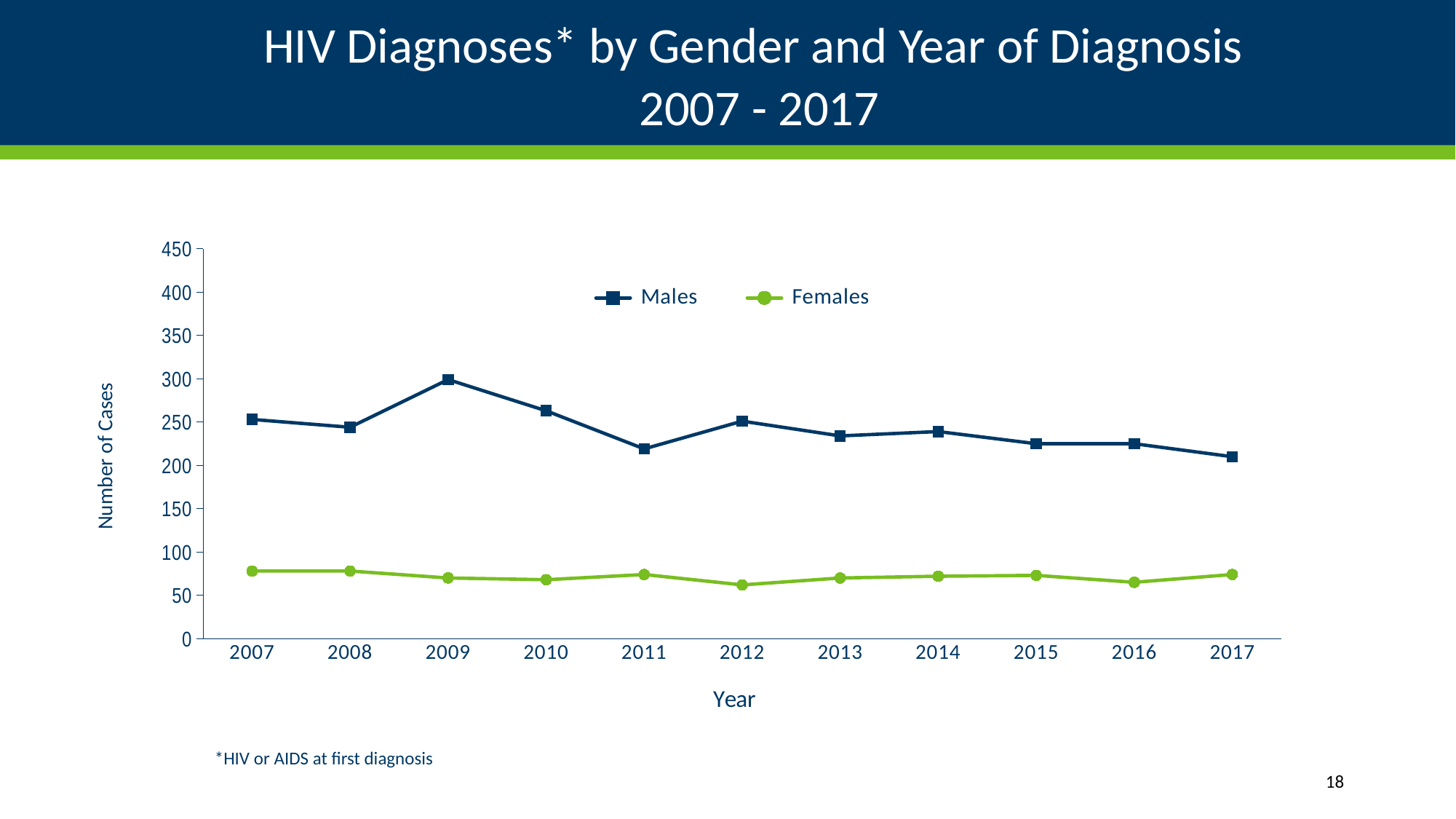
Is the value for Females in 2012 greater or less than 100? less Is the value for Males in 2009 greater or less than 250? greater Which is larger, the value for Males in 2009 or in 2010? 2009 Which series has higher values across all years, Males or Females? Males How many years are plotted along the x axis? 11 Do the values for Males rise or fall from 2012 to 2017? fall In which year is the number of cases for Males highest? 2009 What is the label of the y axis? Number of Cases Is the value for Males in 2011 greater or less than 250? less What kind of chart is shown on the slide? line chart In which year is the number of cases for Males lowest? 2017 How many series does the legend list? 2